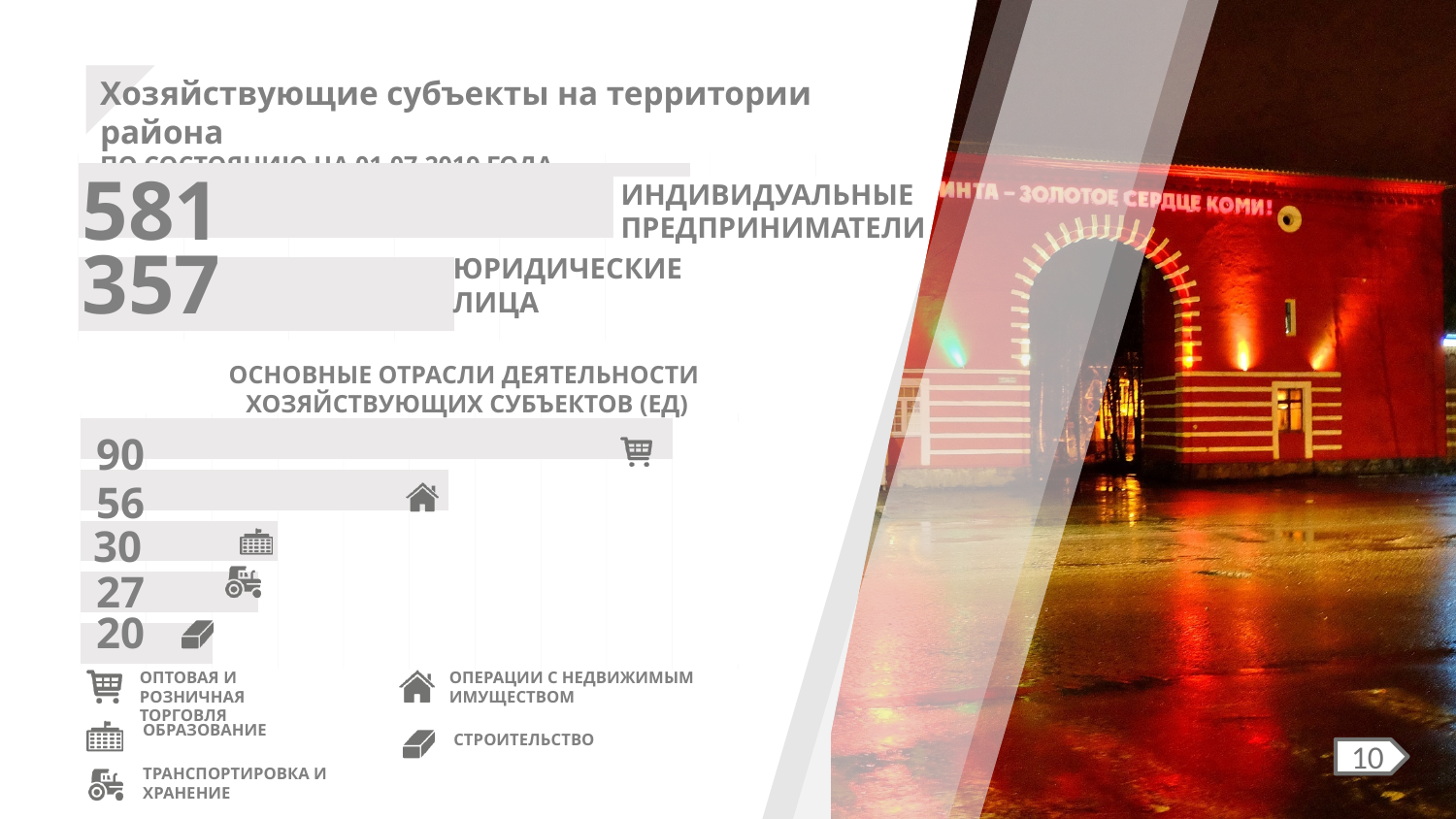
On the chart 'Основные отрасли деятельности хозяйствующих субъектов (ед)', what is the difference between оптовая и розничная торговля and операции с недвижимым имуществом? 34 What kind of chart is 'Основные отрасли деятельности хозяйствующих субъектов (ед)'? Bar chart On the upper chart of the slide, what is the value for индивидуальные предприниматели? 581 On the chart 'Основные отрасли деятельности хозяйствующих субъектов (ед)', what is the value for строительство? 20 On the upper chart of the slide, what is the value for юридические лица? 357 On the chart 'Основные отрасли деятельности хозяйствующих субъектов (ед)', which is larger: образование or транспортировка и хранение? Образование On the upper chart of the slide, what is the difference between индивидуальные предприниматели and юридические лица? 224 On the chart 'Основные отрасли деятельности хозяйствующих субъектов (ед)', which category has the highest value? Оптовая и розничная торговля On the chart 'Основные отрасли деятельности хозяйствующих субъектов (ед)', which category has the lowest value? Строительство How many categories are shown on the chart 'Основные отрасли деятельности хозяйствующих субъектов (ед)'? 5 On the chart 'Основные отрасли деятельности хозяйствующих субъектов (ед)', what is the value for операции с недвижимым имуществом? 56 On the chart 'Основные отрасли деятельности хозяйствующих субъектов (ед)', what is the value for оптовая и розничная торговля? 90